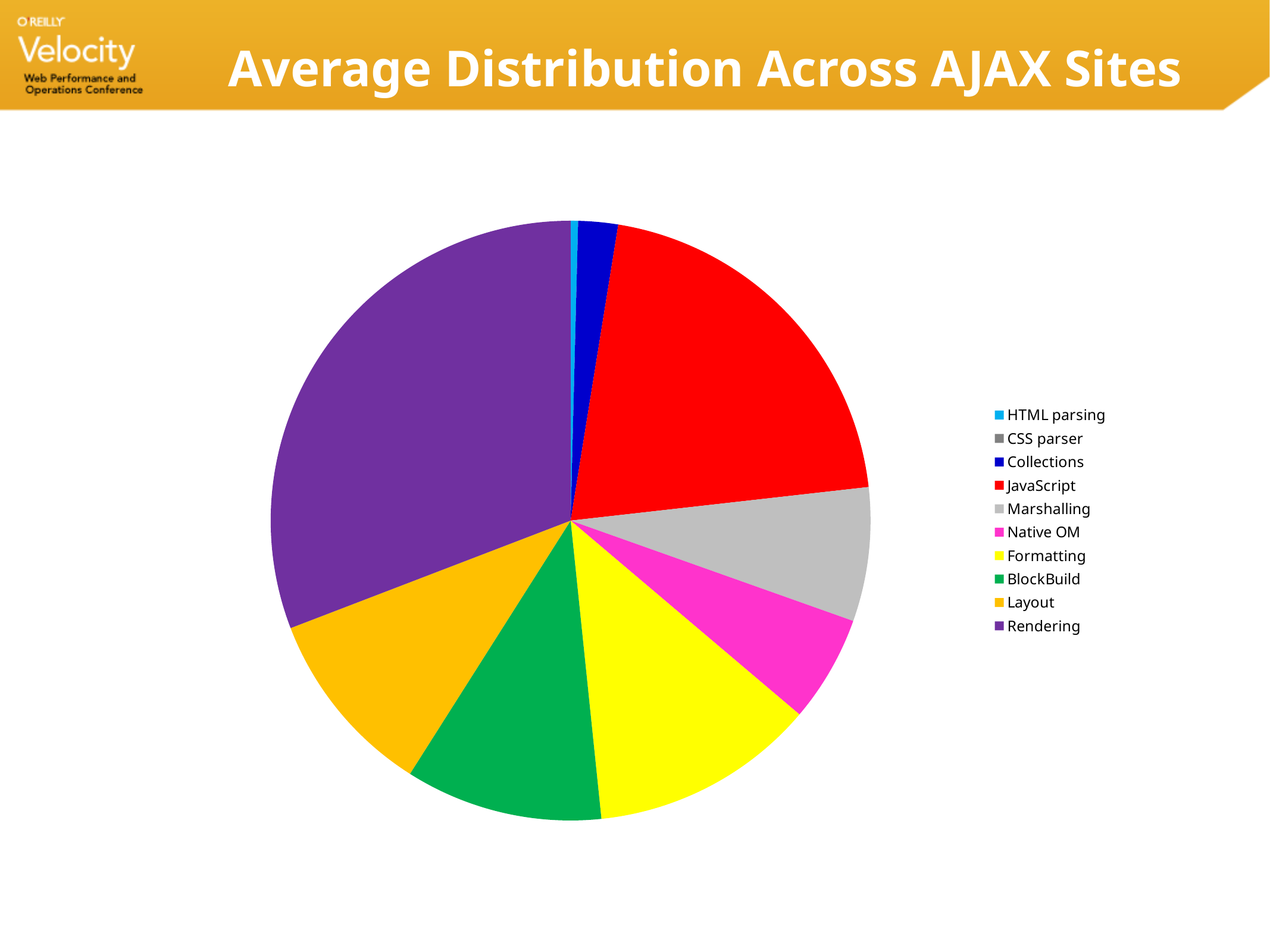
Which slice is larger, Rendering or JavaScript? Rendering Which slice is larger, Collections or HTML parsing? Collections How many categories does the legend list? 10 What is the title of the chart? Average Distribution Across AJAX Sites Which slice is larger, Formatting or Native OM? Formatting What colour is the Rendering slice? purple Which category has the largest slice of the pie? Rendering What kind of chart is shown on the slide? pie chart